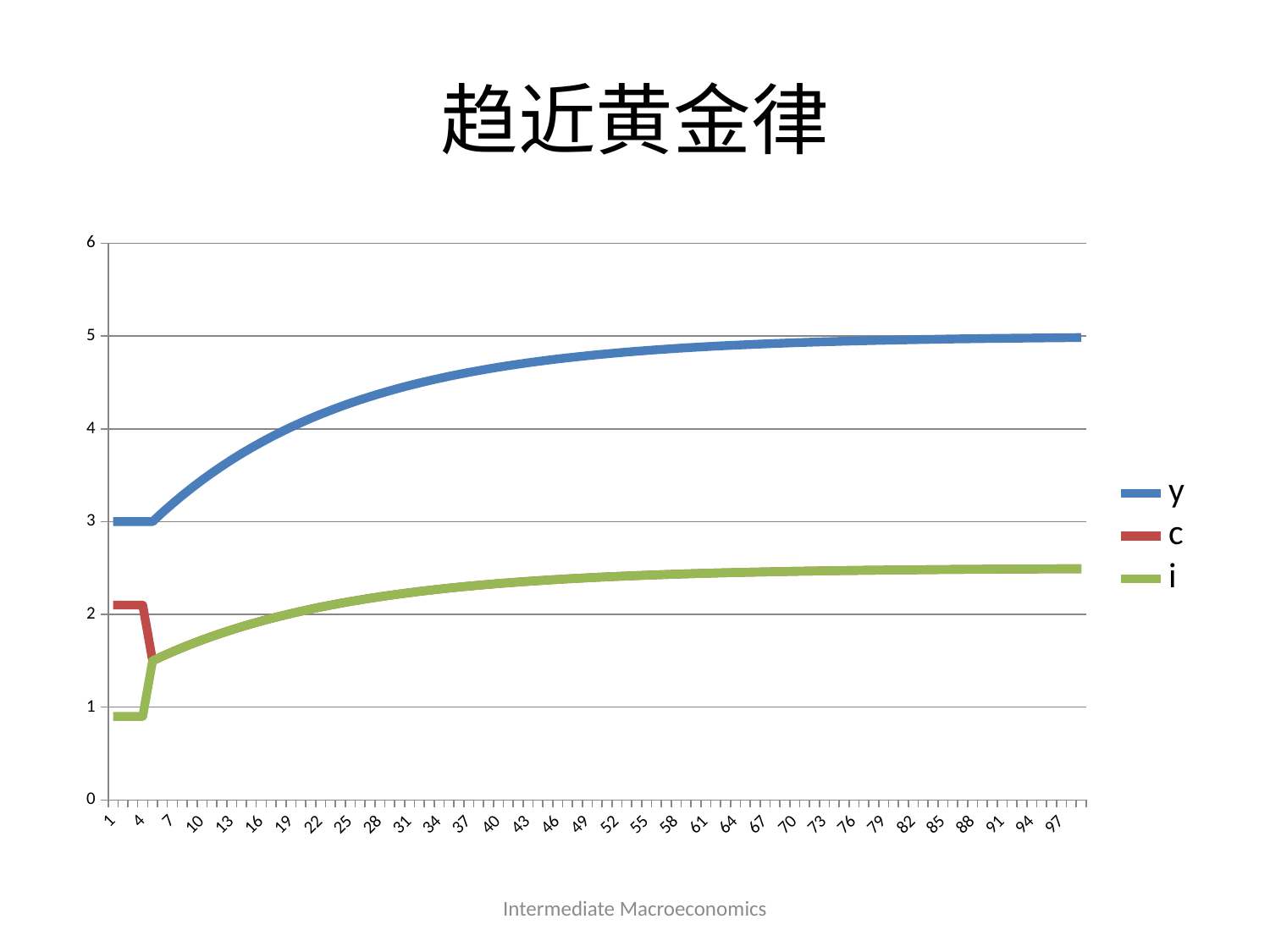
Is the value of series c at period 1 greater or less than 3? less What is the value of series y at period 1? 3 What is the title of the slide containing the chart? 趋近黄金律 Is the value of series i at period 97 greater or less than 3? less Is the value of series i at period 1 greater or less than 1? less What kind of chart is shown on the slide? line chart Which series has the highest value at period 97? y Which series has the lowest value at period 1? i Does series y rise or fall as the period increases along the x axis? rise How many series does the legend list? 3 What are the series names listed in the legend? y, c, i